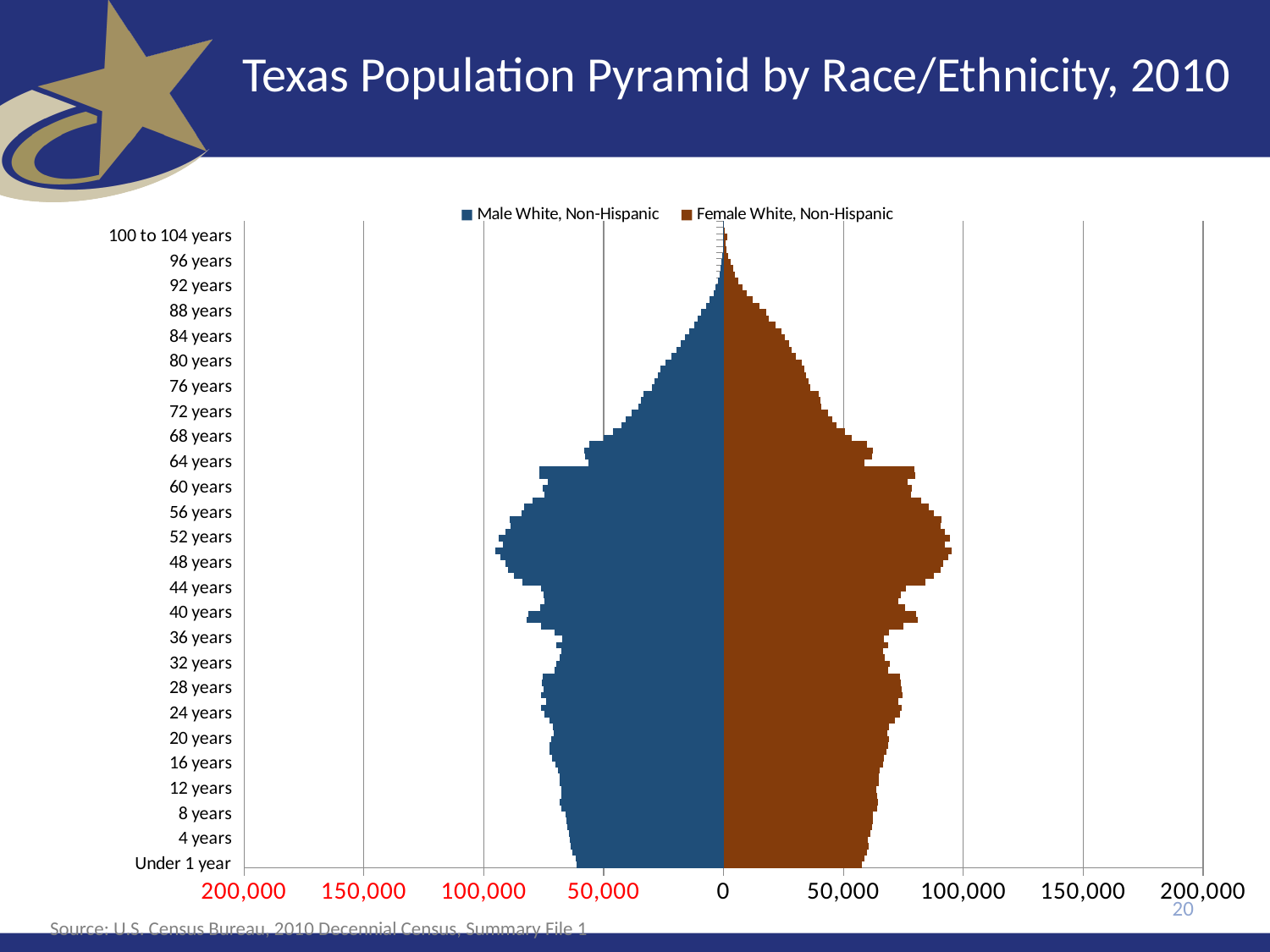
Is the value for Female White, Non-Hispanic at 48 years greater or less than 50,000? greater How many series does the legend list? 2 Is the value for Male White, Non-Hispanic at 48 years greater or less than 50,000? greater Which is larger for Female White, Non-Hispanic: the value at 48 years or the value at 96 years? 48 years Which is larger for Male White, Non-Hispanic: the value at 60 years or the value at 80 years? 60 years From 64 years up to 100 to 104 years, do the Female White, Non-Hispanic values rise or fall as age increases? fall What kind of chart is shown on the slide? Bar chart (population pyramid) What are the two series named in the legend? Male White, Non-Hispanic and Female White, Non-Hispanic Is the value for Male White, Non-Hispanic at 20 years greater or less than 100,000? less What is the title of the chart? Texas Population Pyramid by Race/Ethnicity, 2010